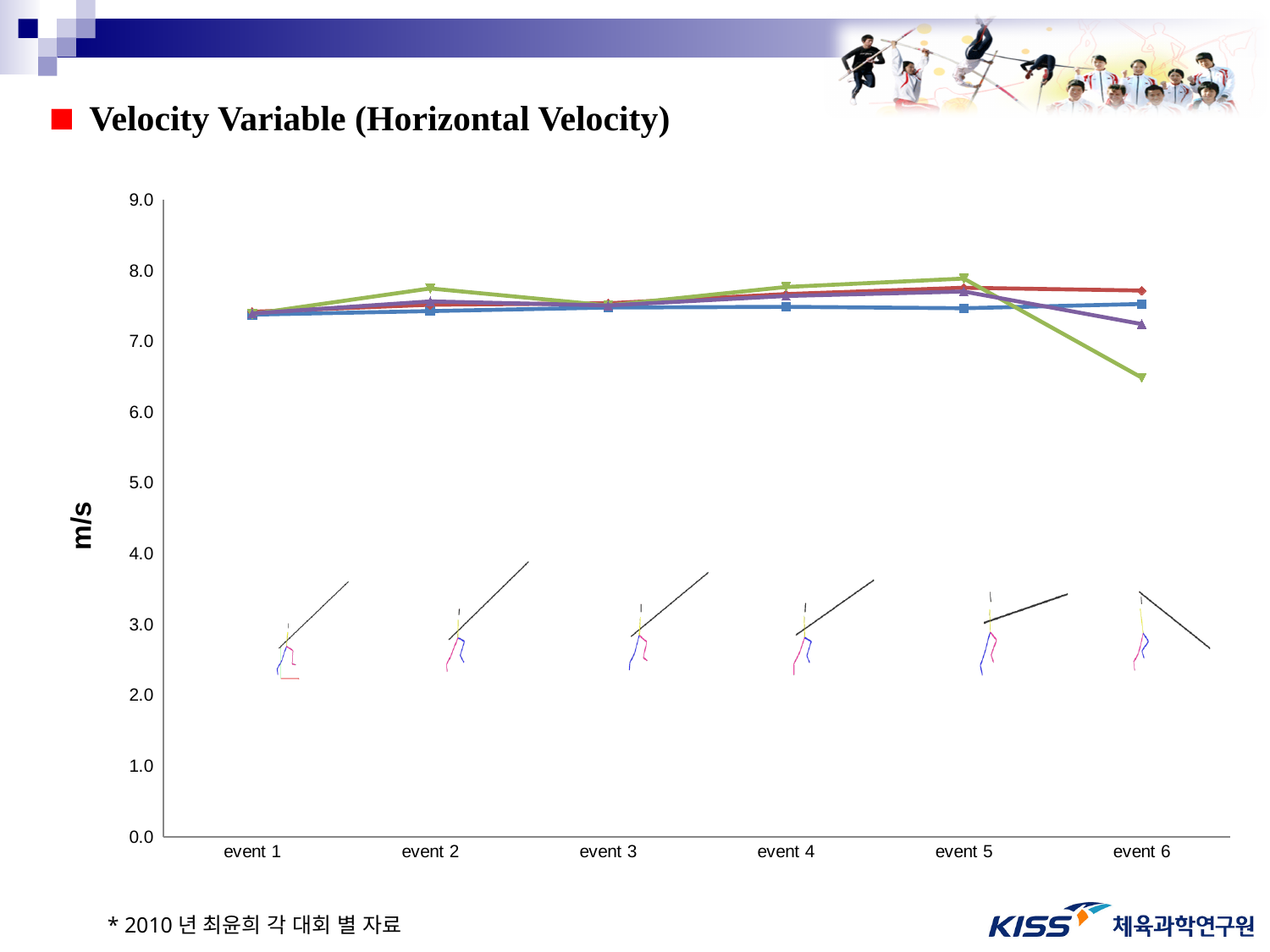
At event 6, which is larger: the value of the blue line or the value of the green line? the blue line Is the value of the red line at event 6 greater or less than 8.0? less What unit is shown on the y axis of the chart? m/s What kind of chart is shown on the slide? line chart How many lines are plotted on the chart? 4 Does the green line rise or fall from event 5 to event 6? fall Which line has the lowest value at event 6? the green line How many events are shown along the x axis of the chart? 6 What is the title of the chart on the slide? Velocity Variable (Horizontal Velocity) Is the value of the green line at event 6 greater or less than 7.0? less Which line has the highest value at event 5? the green line Is the value of the green line at event 1 greater or less than 7.0? greater